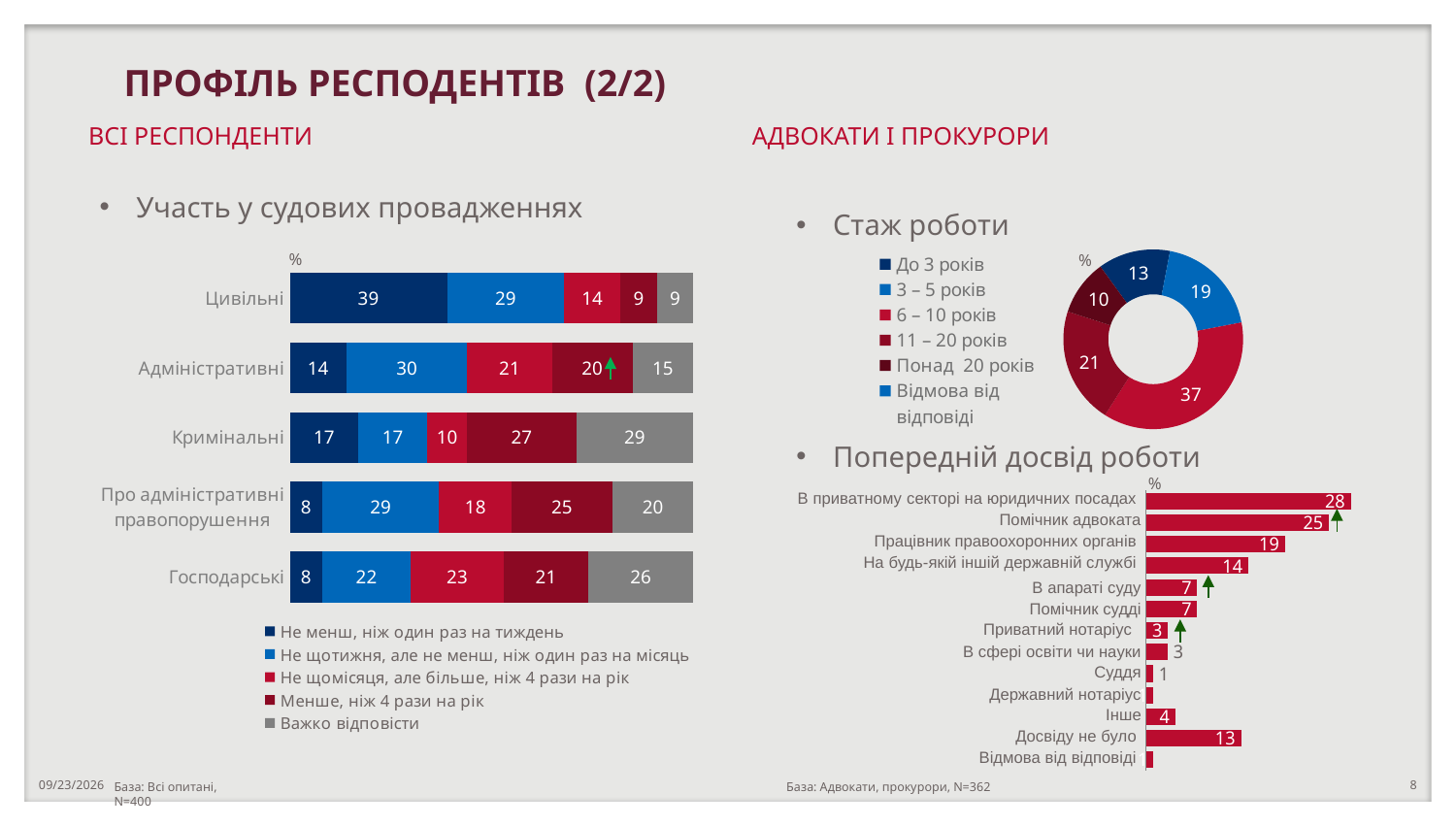
In the 'Попередній досвід роботи' chart, which category has the highest value? В приватному секторі на юридичних посадах In the 'Попередній досвід роботи' chart, which is larger: 'Працівник правоохоронних органів' or 'Досвіду не було'? Працівник правоохоронних органів In the 'Стаж роботи' chart, which labelled segment is the largest? 6 – 10 років In the 'Участь у судових провадженнях' chart, what is the difference between the 'Не щотижня, але не менш, ніж один раз на місяць' values for 'Адміністративні' and 'Господарські'? 8 In the 'Участь у судових провадженнях' chart, which category has the highest value for 'Не менш, ніж один раз на тиждень'? Цивільні In the 'Попередній досвід роботи' chart, what is the value for 'Помічник адвоката'? 25 What kind of chart is the 'Стаж роботи' chart? Donut chart In the 'Попередній досвід роботи' chart, how many categories are shown? 13 In the 'Участь у судових провадженнях' chart, what is the value for 'Не менш, ніж один раз на тиждень' in the 'Цивільні' bar? 39 In the 'Участь у судових провадженнях' chart, how many series does the legend list? 5 In the 'Участь у судових провадженнях' chart, what is the value for 'Важко відповісти' in the 'Кримінальні' bar? 29 In the 'Стаж роботи' chart, what is the value for '6 – 10 років'? 37